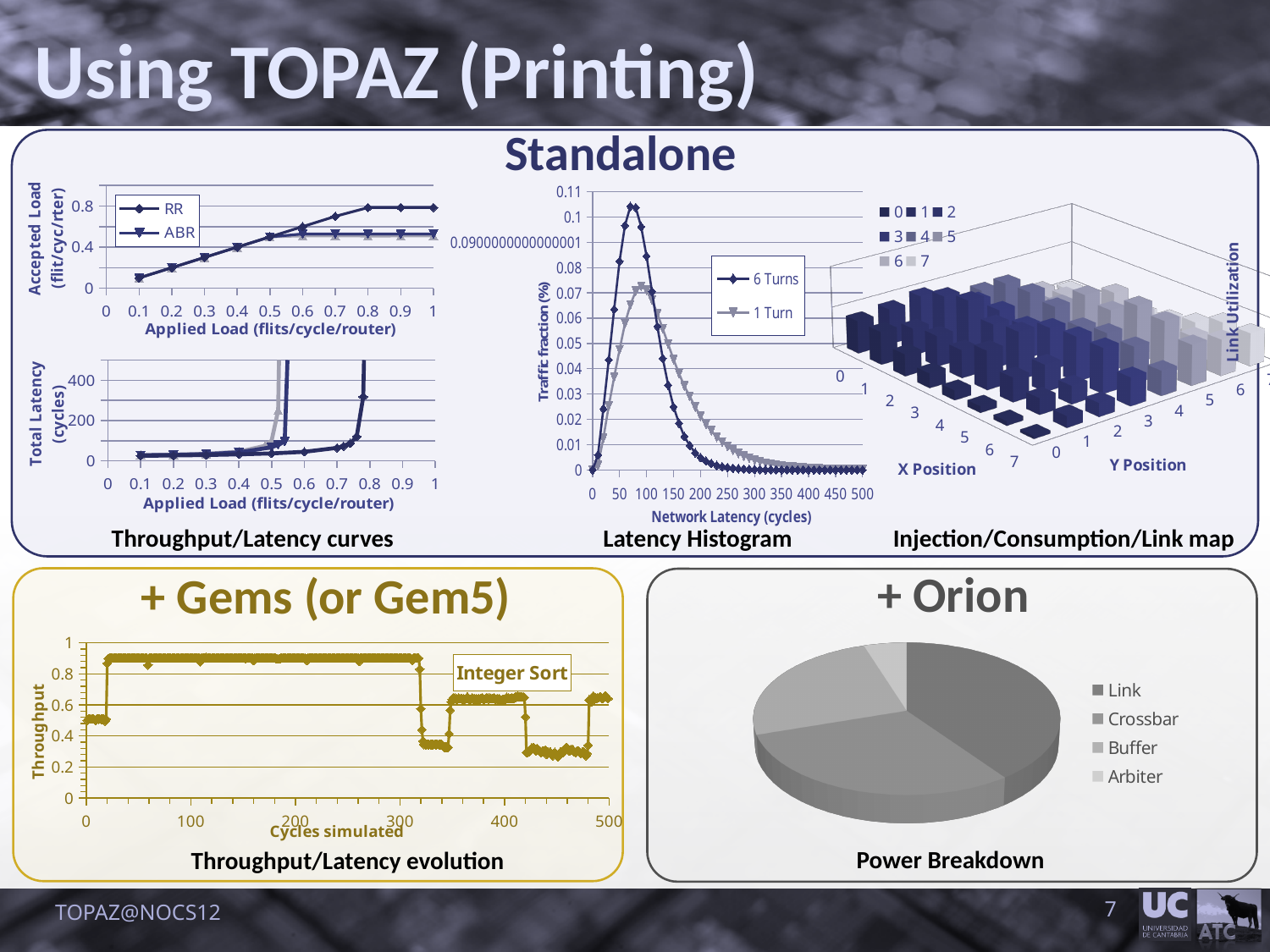
In the Latency Histogram, which series reaches the higher peak traffic fraction, 6 Turns or 1 Turn? 6 Turns How many entries does the legend of the Power Breakdown chart list? 4 In the Latency Histogram, is the peak value of the 1 Turn series greater or less than 0.08? less What kind of chart is the Power Breakdown chart? pie chart In the Latency Histogram, is the peak value of the 6 Turns series greater or less than 0.08? greater In the Power Breakdown pie chart, which component has the smallest slice? Arbiter How many entries does the legend of the Link Utilization 3D chart list? 8 In the Power Breakdown pie chart, which component has the largest slice? Link In the Accepted Load chart (top left), how many series does the legend list? 2 In the Accepted Load chart (top left), is the RR value at an applied load of 1 greater or less than 0.4? greater In the Accepted Load chart (top left), which series has the higher accepted load at an applied load of 1, RR or ABR? RR